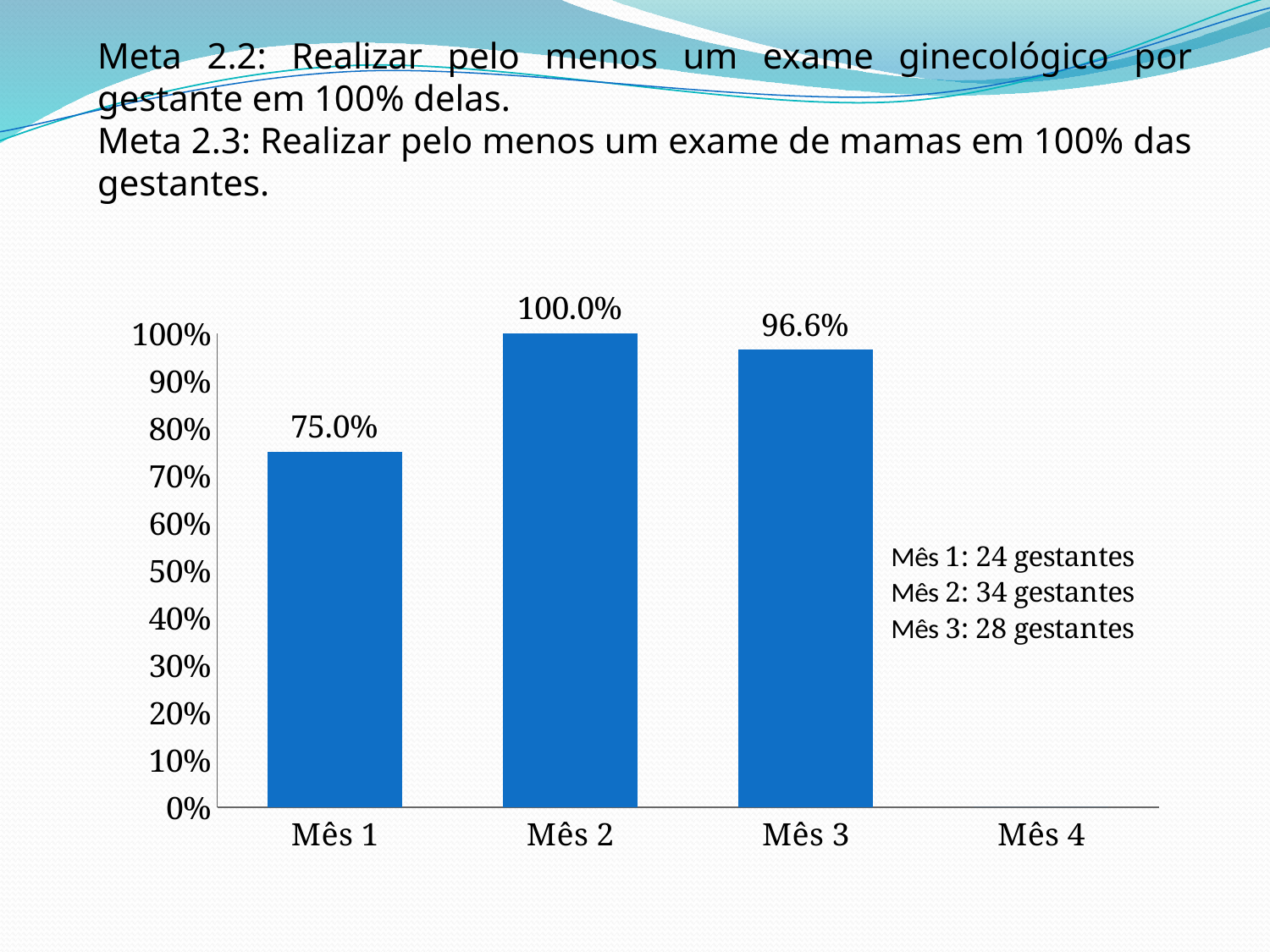
Which month has the highest value? Mês 2 What is the difference between the values for Mês 2 and Mês 1? 25.0% What kind of chart is shown on the slide? bar chart What is the value for Mês 3? 96.6% Which is larger, the value for Mês 1 or the value for Mês 3? Mês 3 What is the value for Mês 2? 100.0% How many categories are shown on the x axis? 4 What is the value for Mês 1? 75.0% According to the note beside the chart, how many gestantes were there in Mês 2? 34 gestantes What is the difference between the values for Mês 2 and Mês 3? 3.4% Among the months with a bar, which has the lowest value? Mês 1 Is the value for Mês 1 greater or less than 80%? less